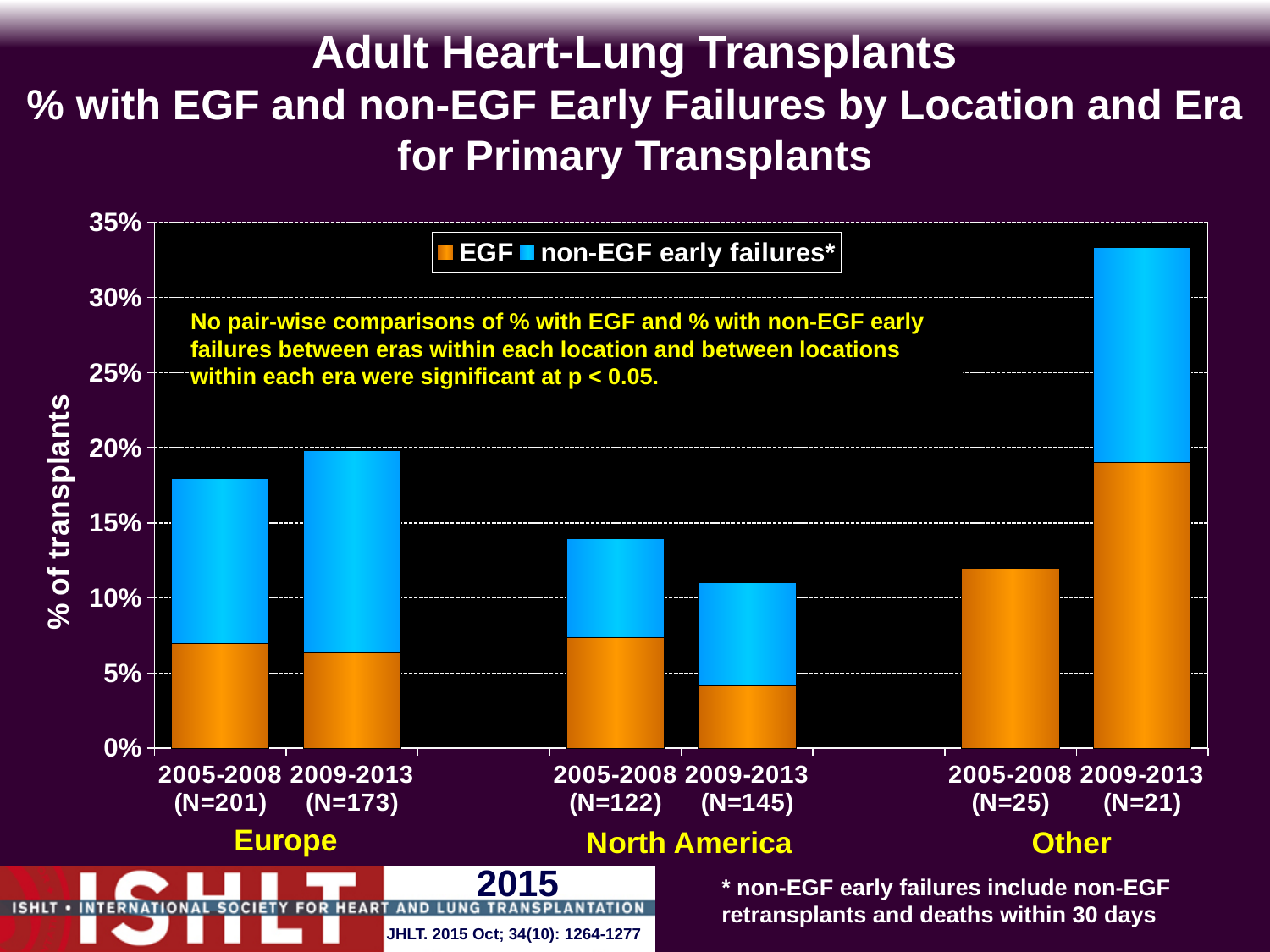
How many bars are plotted in the chart? 6 Which has a larger total % of transplants with early failures, Europe 2009-2013 or North America 2009-2013? Europe 2009-2013 Is the total value for Other 2009-2013 greater or less than 30%? greater How many locations are shown along the x axis? 3 How many series does the legend list? 2 Is the total value for North America 2005-2008 greater or less than 15%? less Which colour represents EGF in the legend? orange Is the total value for Europe 2005-2008 greater or less than 20%? less What is the N for Europe 2005-2008? N=201 Which bar has the highest total % of transplants with early failures? Other 2009-2013 Which bar has the lowest EGF percentage? North America 2009-2013 What kind of chart is shown on the slide? stacked bar chart